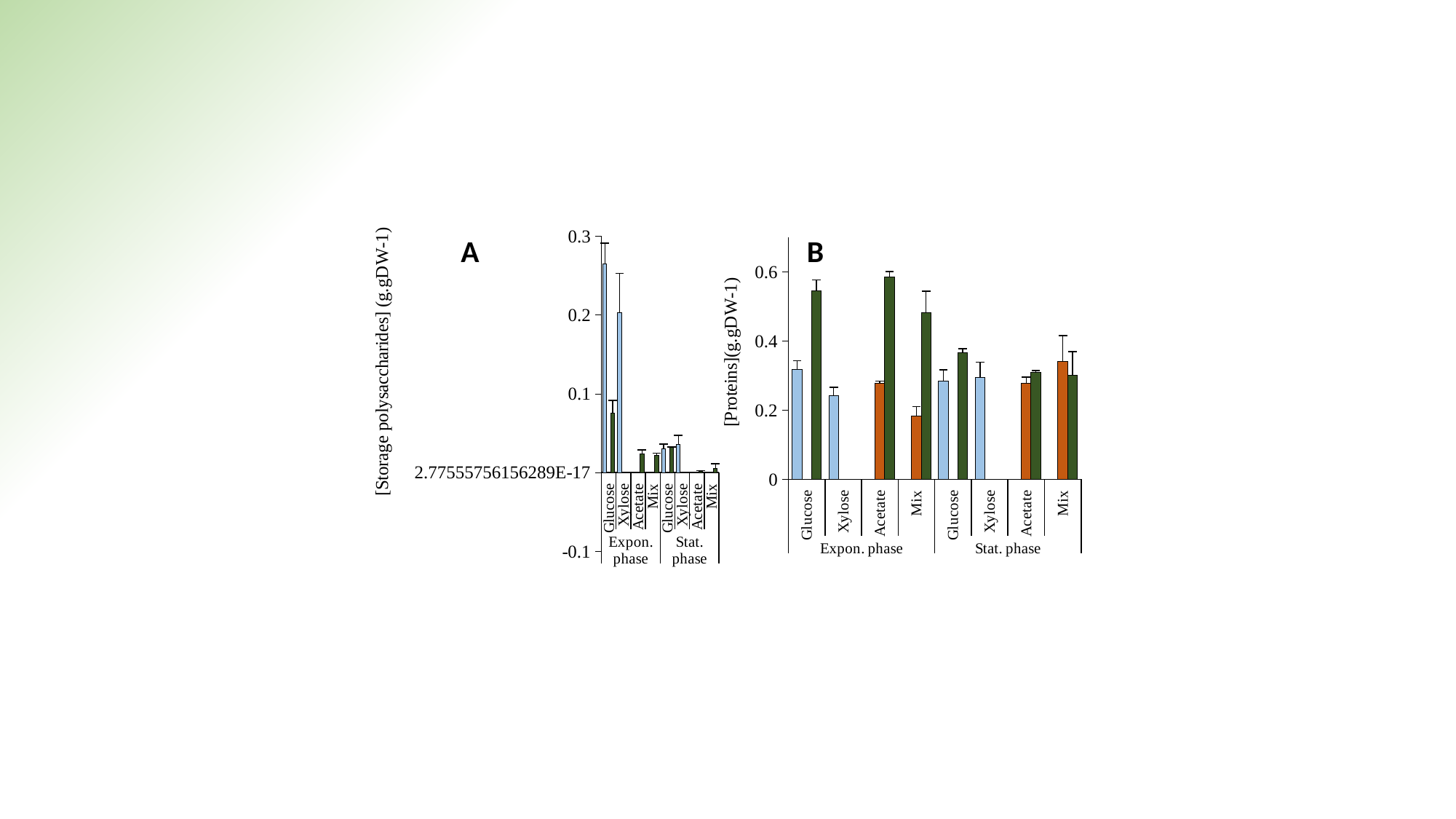
In chart A (Storage polysaccharides), is the light blue bar for Glucose in the Expon. phase greater or less than 0.2? greater In chart B (Proteins), is the dark green bar for Acetate in the Expon. phase greater or less than 0.4? greater In chart B (Proteins), for Glucose in the Expon. phase, which bar is taller: the light blue bar or the dark green bar? the dark green bar In chart B (Proteins), is the orange bar for Mix in the Expon. phase greater or less than 0.2? less How many category labels are shown along the x axis of chart B (Proteins)? 8 In chart A (Storage polysaccharides), for Glucose in the Expon. phase, which bar is taller: the light blue bar or the dark green bar? the light blue bar What kind of chart is chart A (Storage polysaccharides)? bar chart In chart A (Storage polysaccharides), which bar is the tallest? the light blue bar for Glucose in the Expon. phase In chart B (Proteins), is the dark green bar for Acetate taller in the Expon. phase or in the Stat. phase? Expon. phase What is the y-axis title of chart B? [Proteins](g.gDW-1)